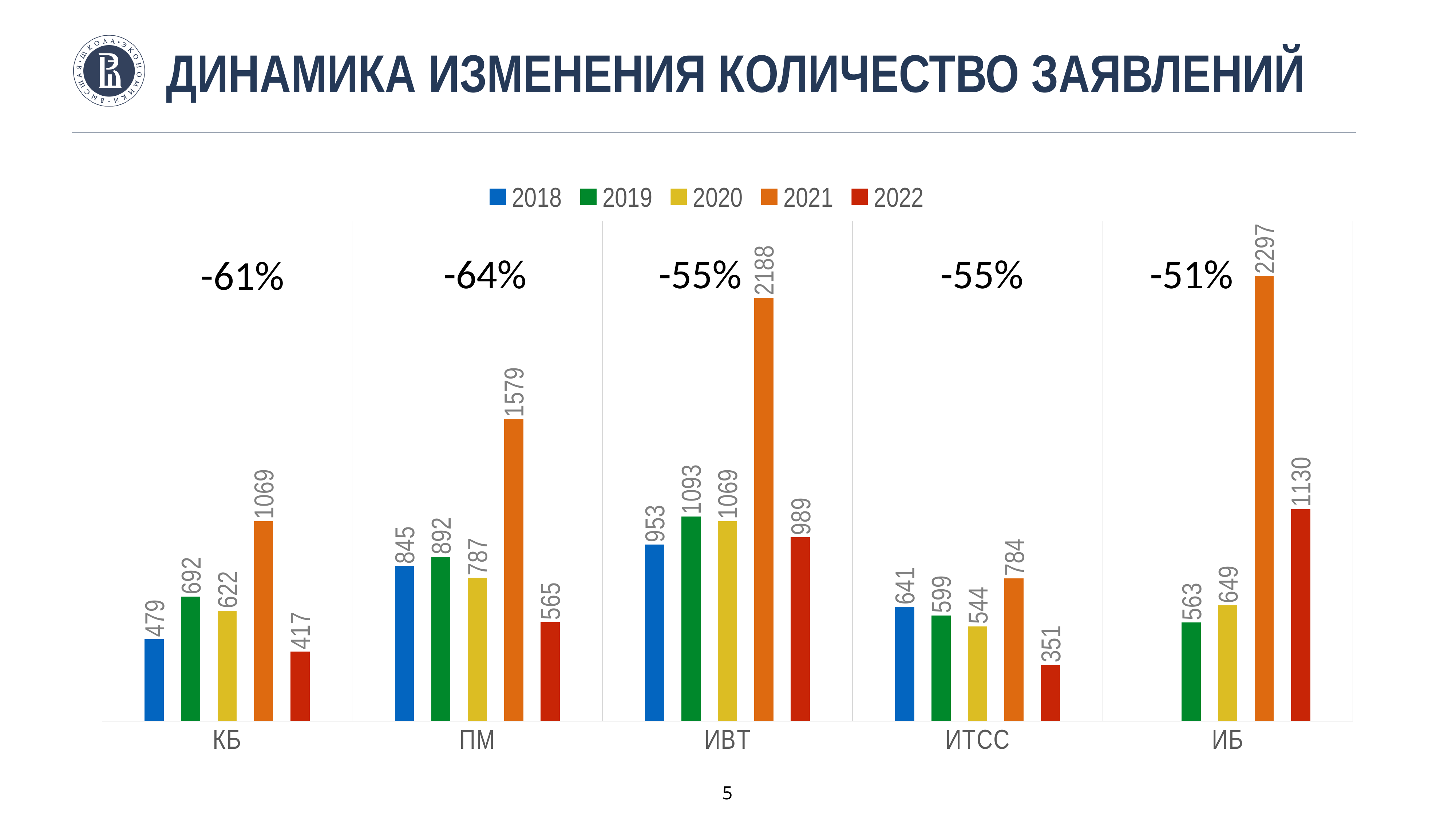
Which category has the lowest value in 2022? ИТСС What is the value for ИТСС in 2020? 544 What is the difference between the 2021 and 2022 values for ПМ? 1014 What kind of chart is shown on the slide? bar chart What is the value for ИБ in 2022? 1130 What is the value for ИВТ in 2021? 2188 How many series does the legend list? 5 How many categories are shown on the x axis? 5 Which is larger for ИВТ: the 2019 value or the 2020 value? 2019 Which category has the highest value in 2021? ИБ What is the value for КБ in 2018? 479 What percentage change is printed above the ПМ group? -64%